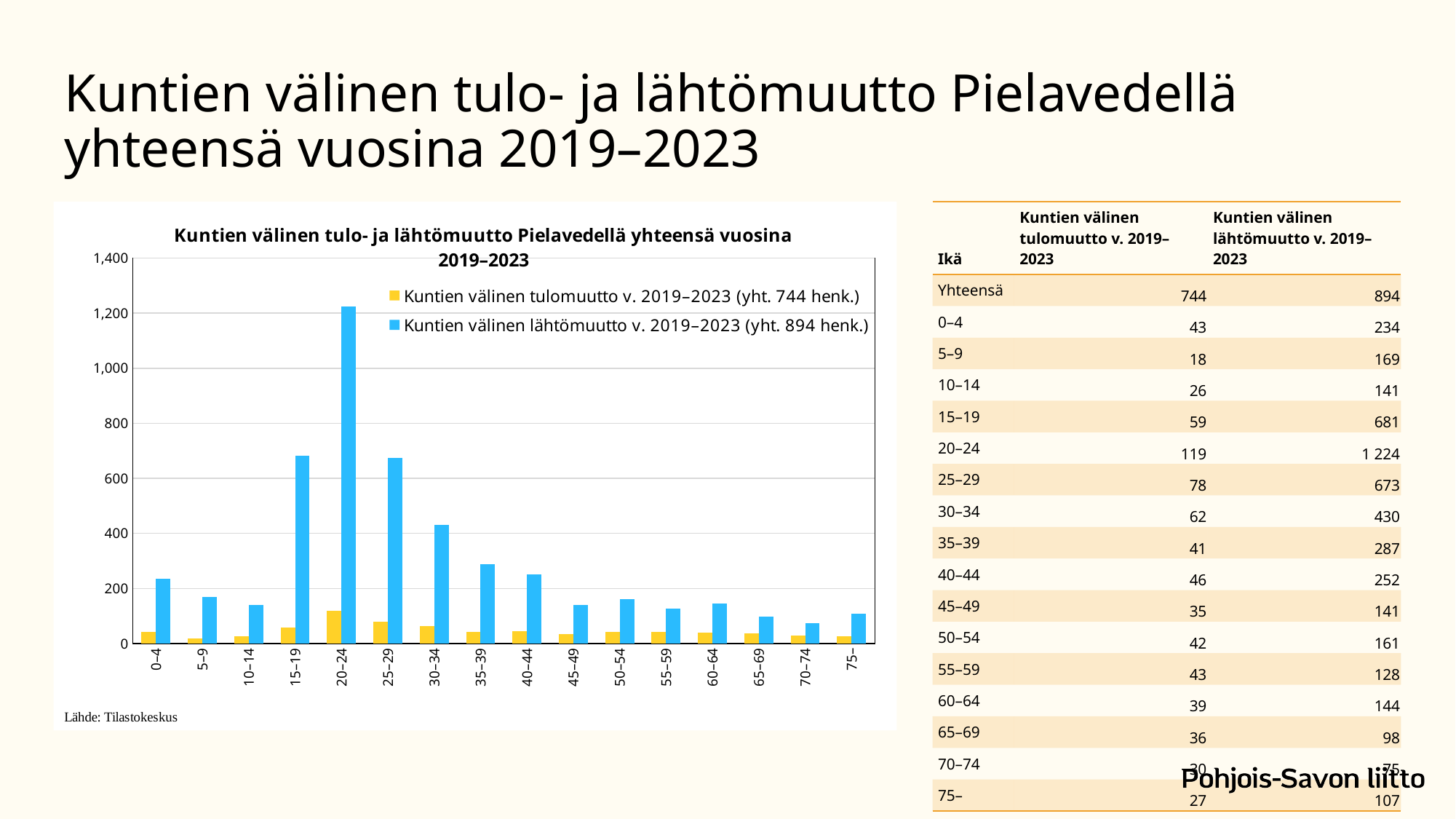
How many series does the chart legend list? 2 Which is larger for the 0–4 age group: tulomuutto or lähtömuutto? lähtömuutto What is the difference between lähtömuutto and tulomuutto for the 25–29 age group? 595 Which age group has the lowest value for Kuntien välinen tulomuutto v. 2019–2023? 5–9 Which age group has the highest value for Kuntien välinen lähtömuutto v. 2019–2023? 20–24 Is the lähtömuutto value for the 30–34 age group greater or less than 400? greater What is the value of Kuntien välinen lähtömuutto v. 2019–2023 for the 20–24 age group? 1 224 What type of chart is shown on the slide? bar chart According to the legend, what is the total number of people for Kuntien välinen tulomuutto v. 2019–2023? 744 henk. Which colour represents Kuntien välinen lähtömuutto v. 2019–2023 in the chart? blue How many age groups are shown on the x axis of the chart? 16 What is the value of Kuntien välinen tulomuutto v. 2019–2023 for the 15–19 age group? 59